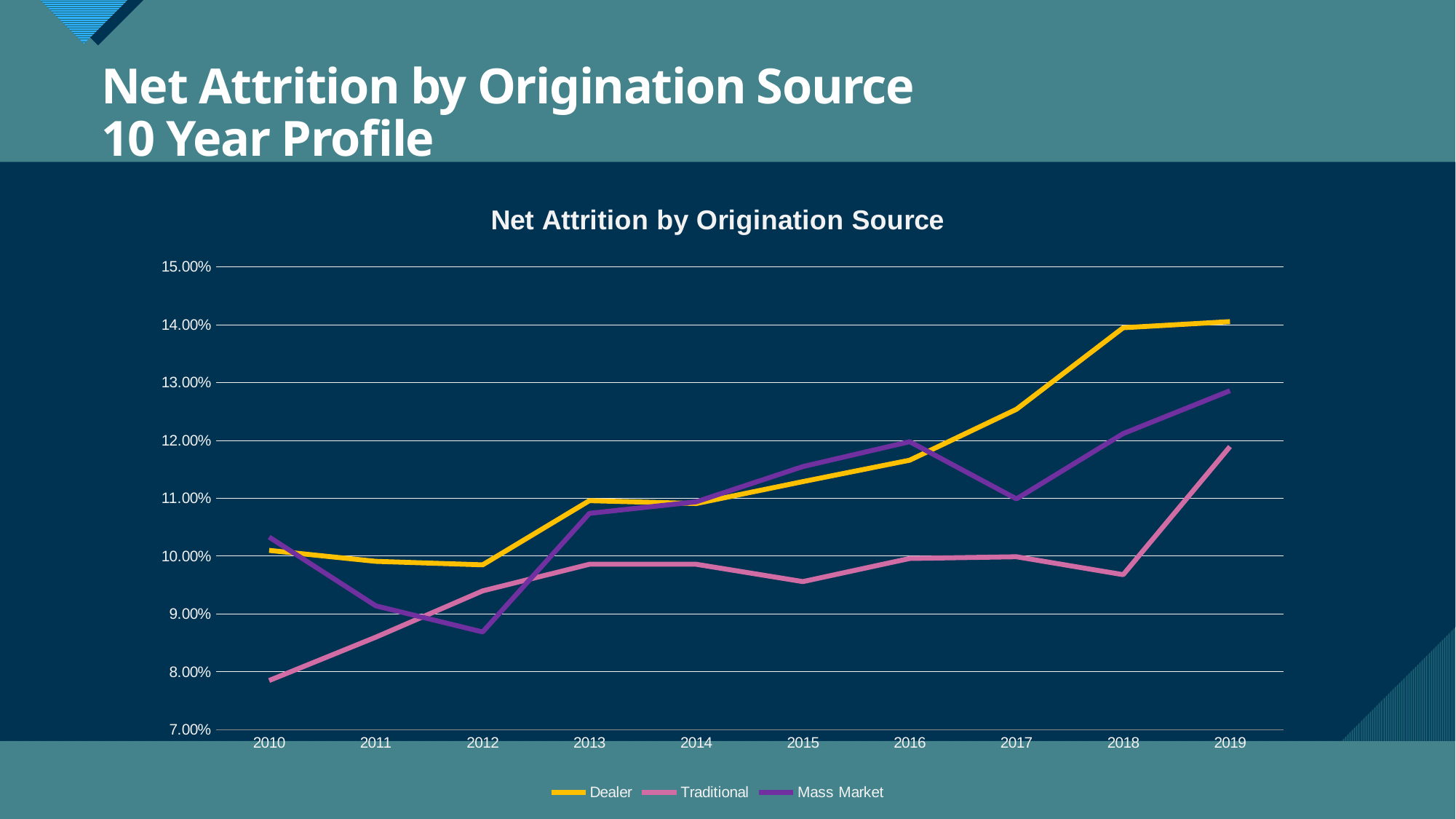
Is the value for Mass Market in 2012 greater or less than 9.00%? less In 2017, which is larger: Mass Market or Traditional? Mass Market Which series has the lowest value in 2010? Traditional Is the value for Dealer in 2018 greater or less than 13.00%? greater How many years are plotted along the x axis? 10 Which series has the highest value in 2019? Dealer Is the value for Traditional in 2010 greater or less than 8.00%? less How many series does the legend list? 3 What kind of chart is shown on the slide? Line chart In which year is the Mass Market series at its lowest? 2012 Does the Dealer series rise or fall from 2012 to 2019? Rise